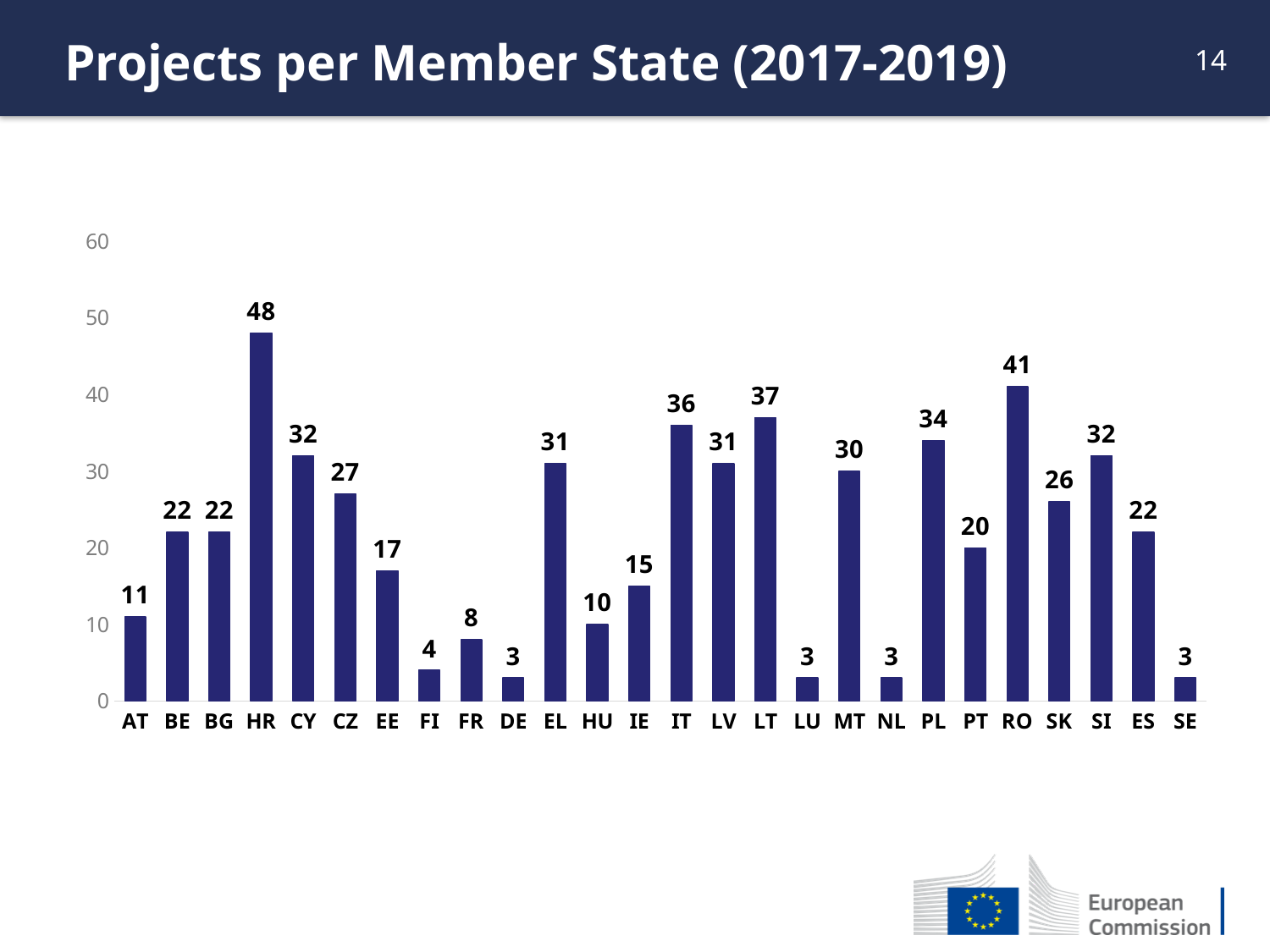
What is the difference between the values for HR and RO? 7 What kind of chart is shown on the slide? Bar chart Which has more projects, PL or MT? PL How many Member States are shown on the x axis? 26 What is the title of the chart? Projects per Member State (2017-2019) Which has more projects, EE or IE? EE How many projects does HR have? 48 What is the difference between the values for LT and IT? 1 How many projects are shown for PT? 20 What is the lowest value shown on the chart? 3 What is the value shown for RO? 41 Which Member State has the highest number of projects? HR